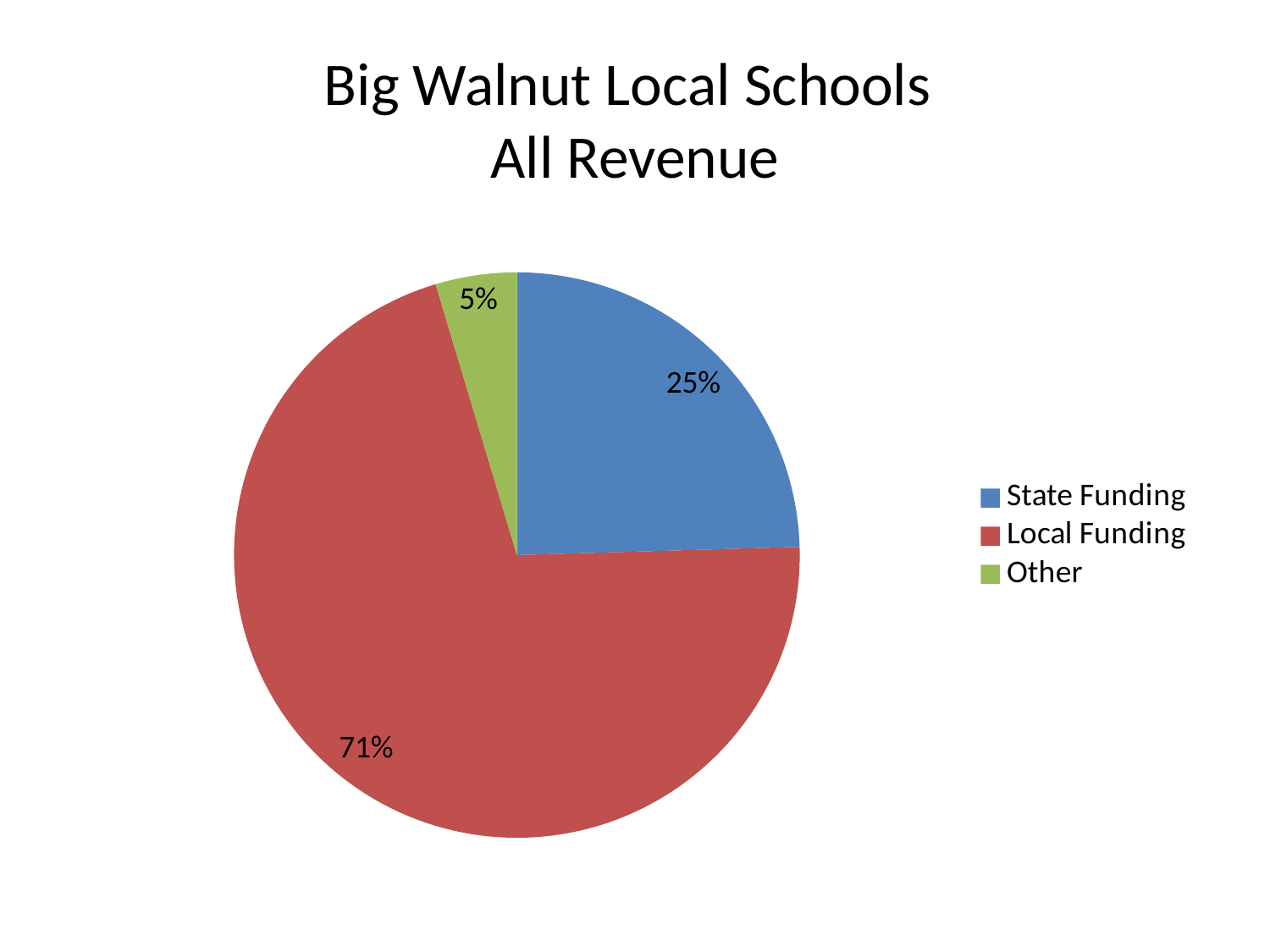
How many percentage points larger is the Local Funding share than the State Funding share? 46 How many percentage points larger is the State Funding share than the Other share? 20 How many categories does the pie chart show? 3 Which colour represents Local Funding in the pie chart? Red What share of all revenue comes from State Funding? 25% What is the title of the chart? Big Walnut Local Schools All Revenue Which revenue source has the smallest slice of the pie? Other Which is larger, the State Funding share or the Other share? State Funding What share of all revenue comes from Local Funding? 71% What share of all revenue is labelled Other? 5% What kind of chart is shown on the slide? Pie chart Which revenue source has the largest slice of the pie? Local Funding